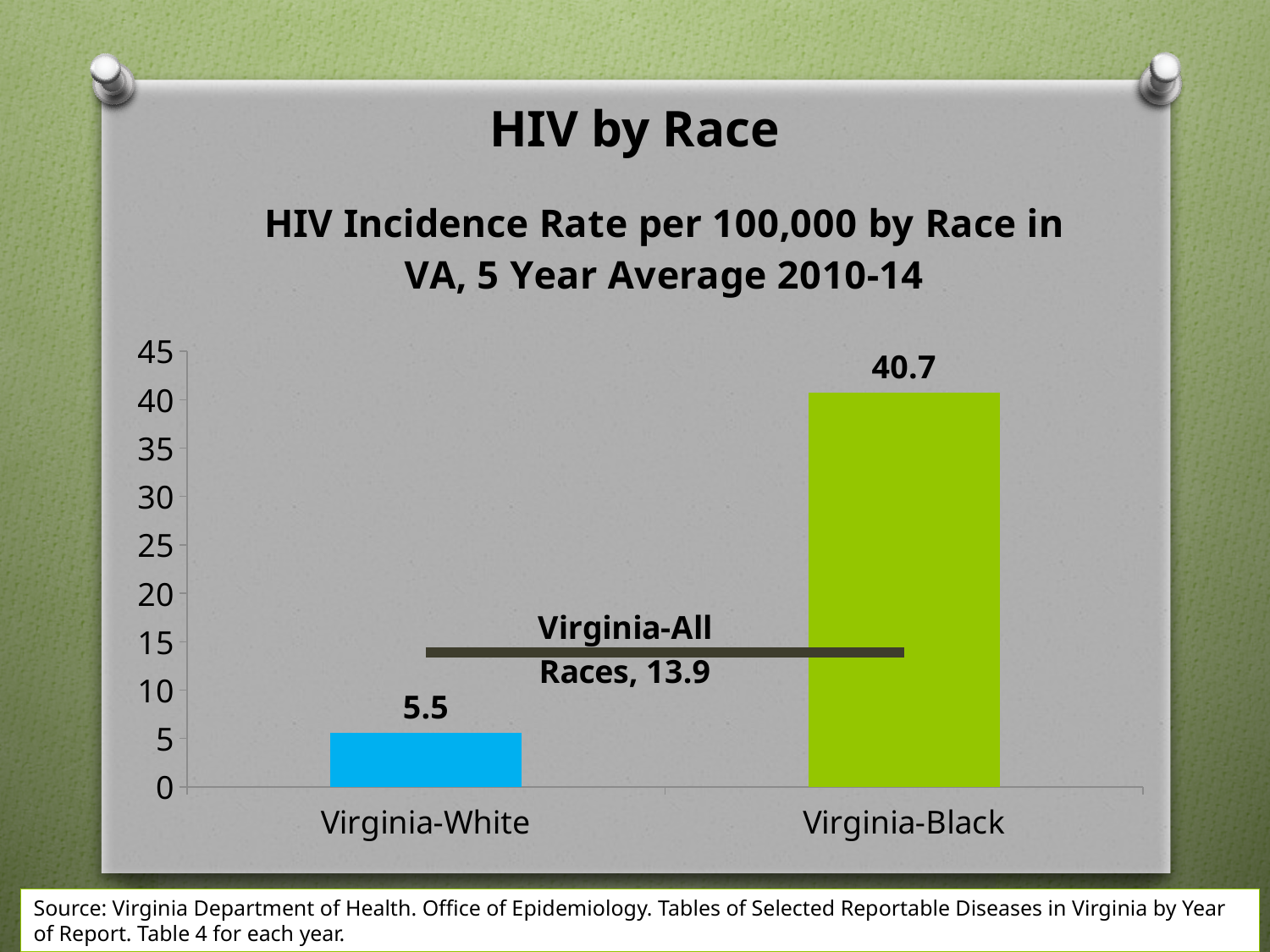
Which race category has the lowest HIV incidence rate? Virginia-White What value is shown for Virginia-All Races? 13.9 What is the difference between the Virginia-Black and Virginia-White HIV incidence rates? 35.2 What is the HIV incidence rate per 100,000 for Virginia-Black? 40.7 Is the value for Virginia-Black greater or less than 40? greater What is the HIV incidence rate per 100,000 for Virginia-White? 5.5 What is the difference between the Virginia-Black rate and the Virginia-All Races rate? 26.8 What kind of chart is shown on the slide? combination bar and line chart (bars with a horizontal reference line) Which race category has the highest HIV incidence rate? Virginia-Black What is the title of the chart? HIV Incidence Rate per 100,000 by Race in VA, 5 Year Average 2010-14 Is the HIV incidence rate for Virginia-White higher or lower than the Virginia-All Races rate? lower How many race categories are shown as bars on the x axis? 2